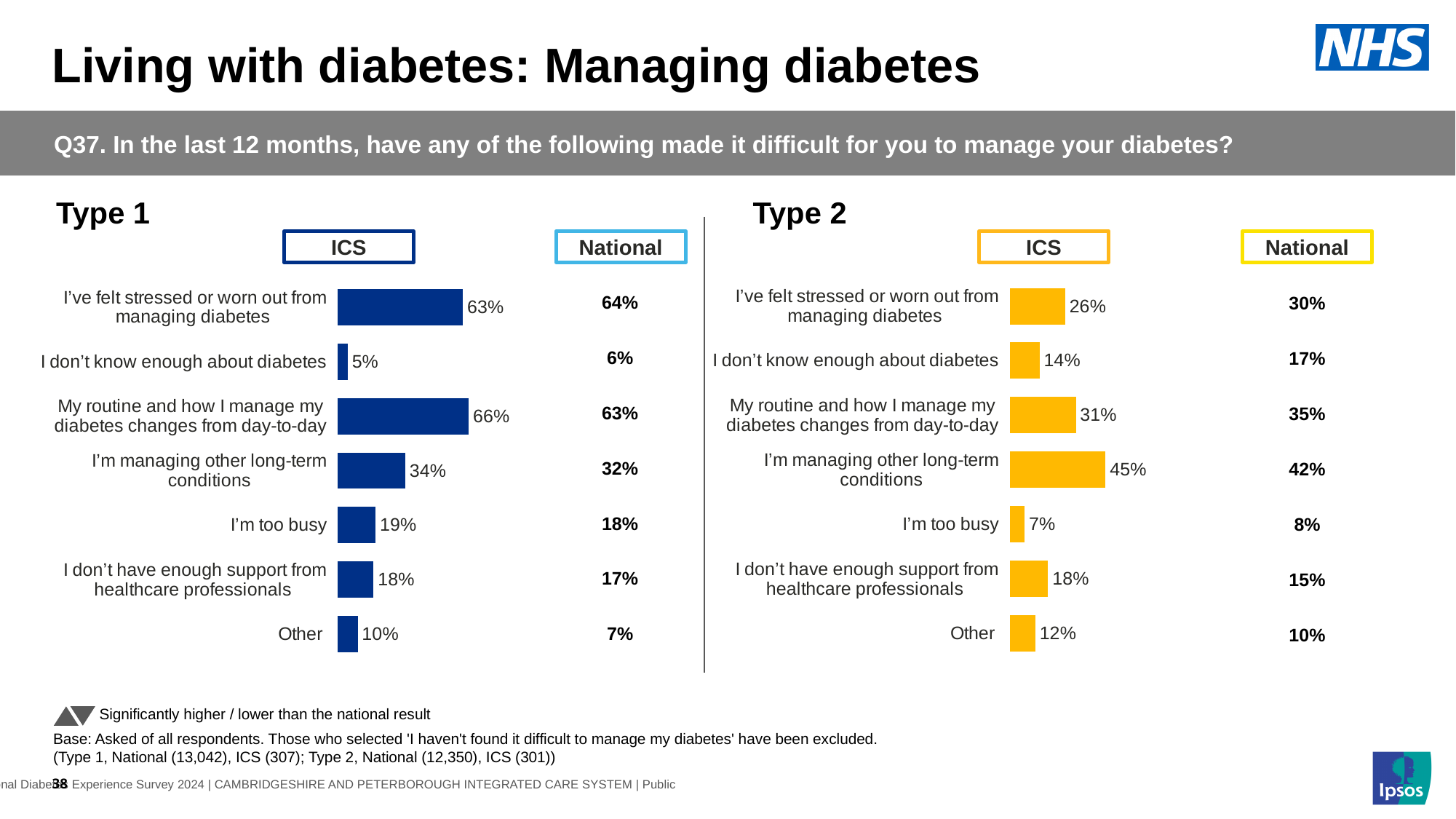
In the Type 2 chart, which category has the highest ICS value? I'm managing other long-term conditions In the Type 2 chart, which is larger for 'I'm managing other long-term conditions': the ICS value or the National value? ICS How many categories are shown in the Type 1 chart? 7 In the Type 1 chart, what is the National value for 'Other'? 7% In the Type 1 chart, what is the difference between the ICS and National values for 'Other'? 3% In the Type 2 chart, what is the ICS value for 'I don't know enough about diabetes'? 14% In the Type 1 chart, which category has the highest ICS value? My routine and how I manage my diabetes changes from day-to-day In the Type 2 chart, what is the difference between the ICS and National values for 'I've felt stressed or worn out from managing diabetes'? 4% In the Type 2 chart, which category has the lowest ICS value? I'm too busy What type of chart is used to show the ICS values for Type 1? Bar chart In the Type 2 chart, what is the National value for 'I'm managing other long-term conditions'? 42% In the Type 1 chart, what is the ICS value for 'I'm managing other long-term conditions'? 34%